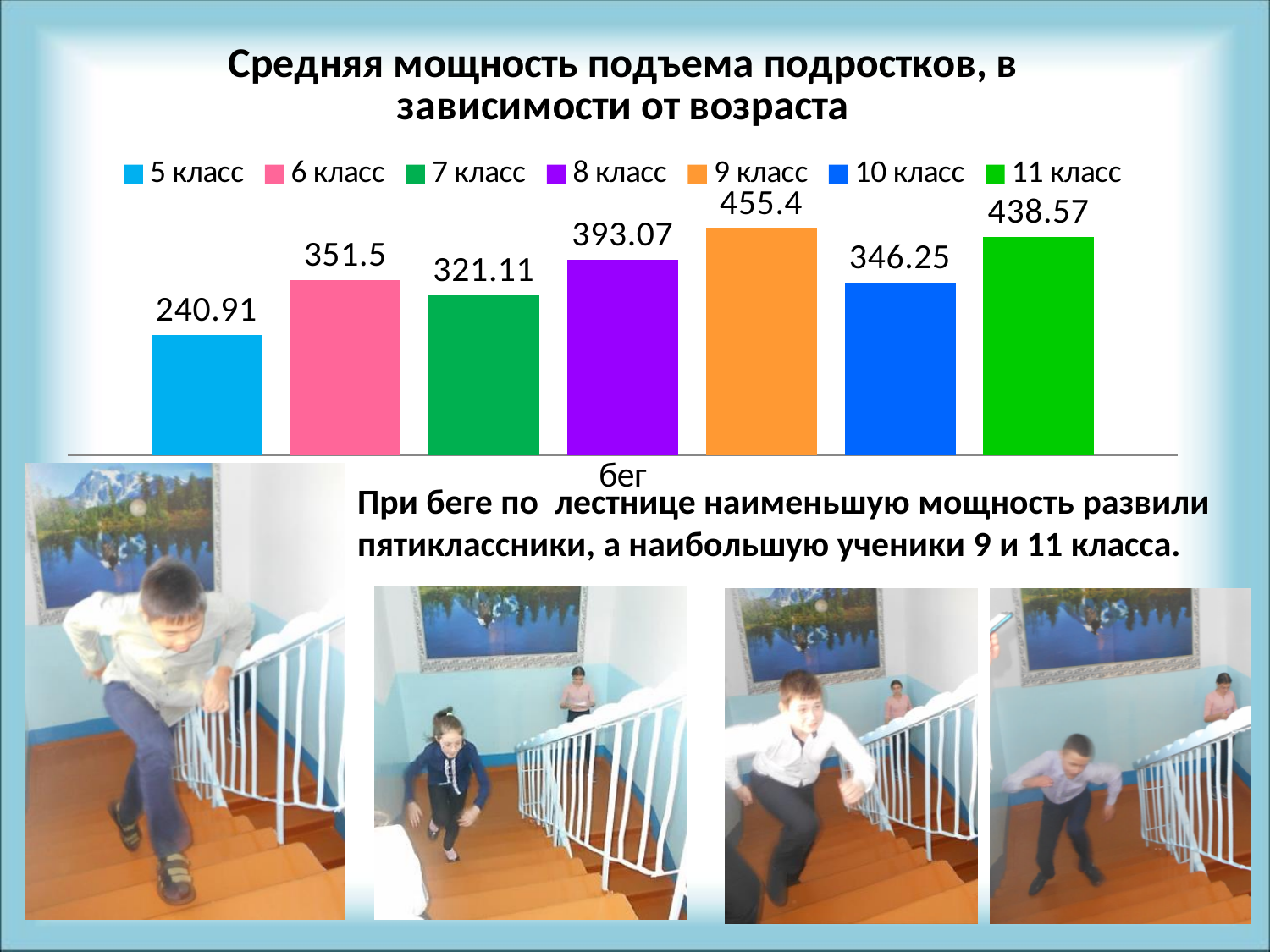
Which class has the highest value? 9 класс What is the value for 11 класс? 438.57 What is the difference between the values for 6 класс and 10 класс? 5.25 What is the value for 9 класс? 455.4 How many series does the legend list? 7 What is the difference between the values for 9 класс and 5 класс? 214.49 What is the value for 7 класс? 321.11 What is the value for 5 класс? 240.91 What is the title of the chart? Средняя мощность подъема подростков, в зависимости от возраста Which is larger, the value for 8 класс or the value for 10 класс? 8 класс Which class has the lowest value? 5 класс What kind of chart is shown on the slide? bar chart